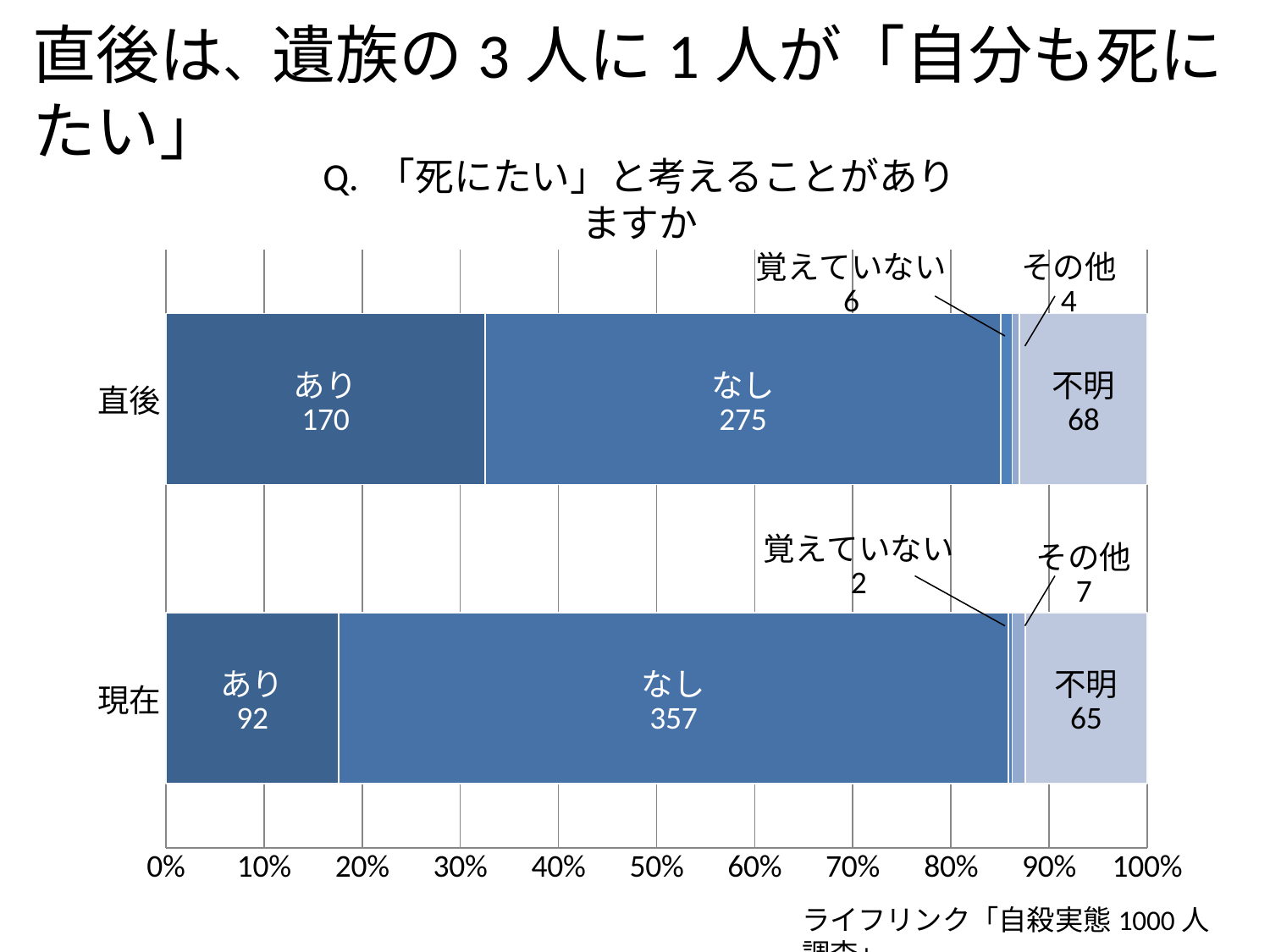
What is the total of all segments in the 直後 bar? 523 What is the value of 不明 for 直後? 68 What is the difference between あり for 直後 and あり for 現在? 78 What is the value of その他 for 直後? 4 Is the share of あり in the 直後 bar greater or less than 30%? greater How many categories (bars) does the chart show? 2 What kind of chart is shown on the slide? bar chart What is the title of the chart? Q. 「死にたい」と考えることがありますか Which is larger: なし for 直後 or なし for 現在? なし for 現在 What is the value of あり for 直後? 170 What is the value of なし for 現在? 357 What is the value of 覚えていない for 現在? 2